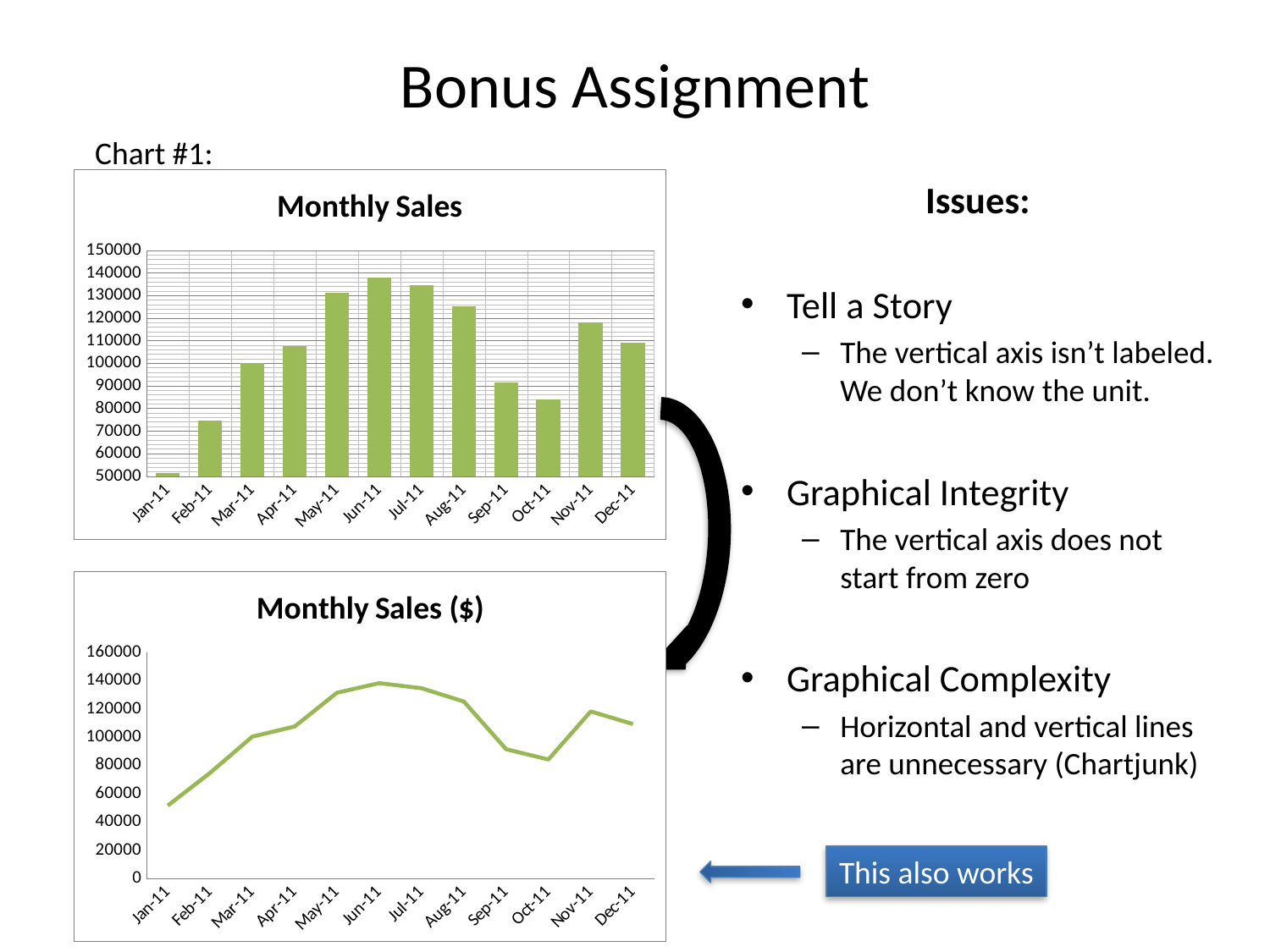
In the bottom "Monthly Sales ($)" line chart, do the values rise or fall from Jan-11 to Jun-11? rise In the bottom "Monthly Sales ($)" line chart, is the value for Oct-11 greater or less than 100000? less What kind of chart is the top chart titled "Monthly Sales"? bar chart What is the lowest tick value shown on the vertical axis of the top "Monthly Sales" bar chart? 50000 In the top "Monthly Sales" bar chart, is the value for May-11 greater or less than 120000? greater In the top "Monthly Sales" bar chart, which month has the highest value? Jun-11 In the top "Monthly Sales" bar chart, is the value for Feb-11 greater or less than 80000? less What kind of chart is the bottom chart titled "Monthly Sales ($)"? line chart In the top "Monthly Sales" bar chart, which is larger, the value for Nov-11 or the value for Sep-11? Nov-11 How many months are plotted on the x axis of the bottom "Monthly Sales ($)" line chart? 12 What is the title of the bottom chart on the slide? Monthly Sales ($) In the top "Monthly Sales" bar chart, which month has the lowest value? Jan-11